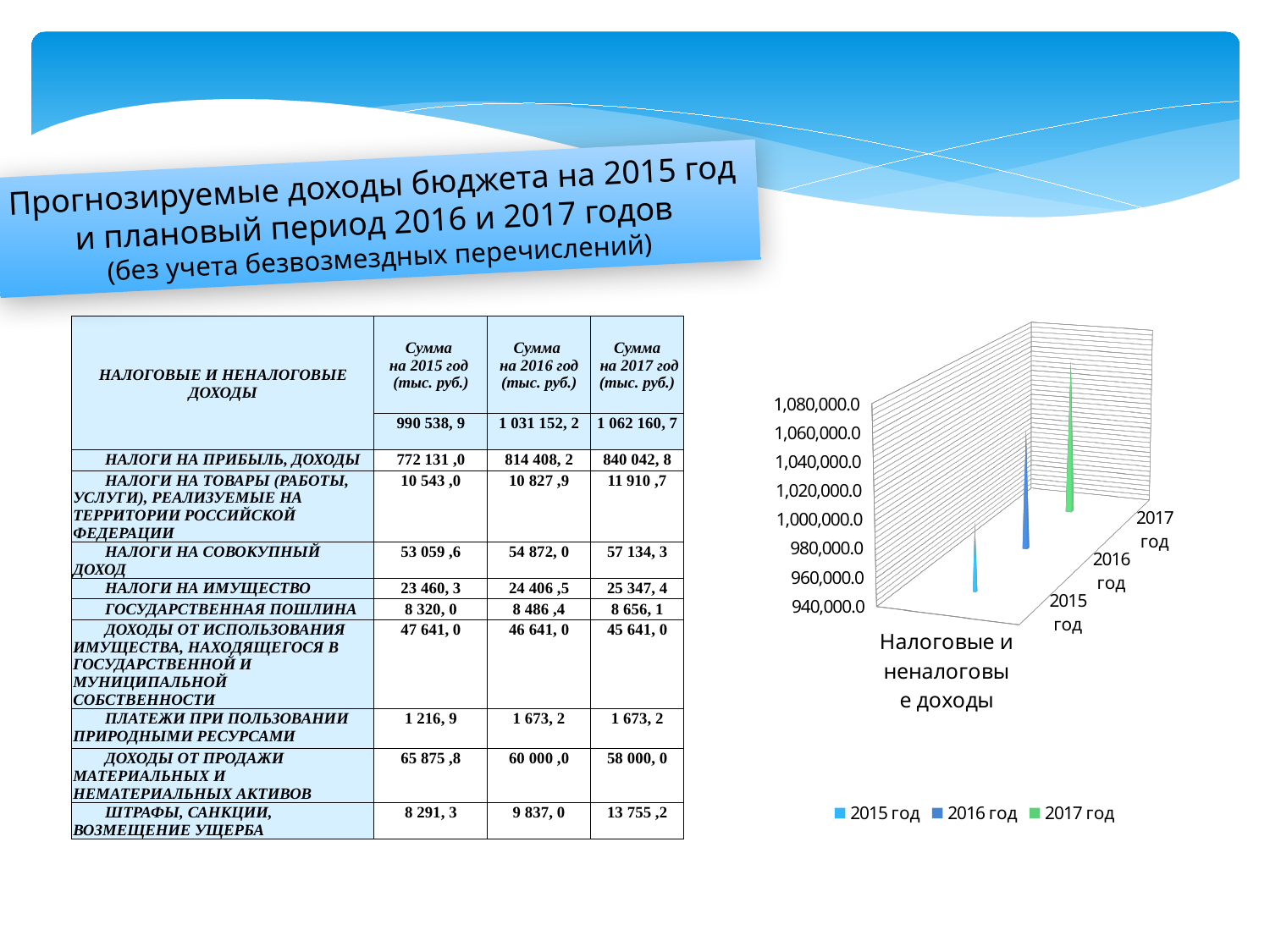
Is the value for 2016 год on the chart greater or less than 1,000,000.0? greater What is the highest tick value shown on the chart's vertical axis? 1,080,000.0 How many series does the chart legend list? 3 Do the values on the chart rise or fall from 2015 to 2017? rise What are the series names listed in the chart legend? 2015 год, 2016 год, 2017 год Which year's series has the highest value on the chart? 2017 год Is the value for 2017 год on the chart greater or less than 1,040,000.0? greater How many categories are plotted on the chart's horizontal axis? 1 What category label is shown on the chart's horizontal axis? Налоговые и неналоговые доходы Which is larger on the chart, the value for 2016 год or the value for 2015 год? 2016 год Is the value for 2015 год on the chart greater or less than 1,020,000.0? less Which year's series has the lowest value on the chart? 2015 год